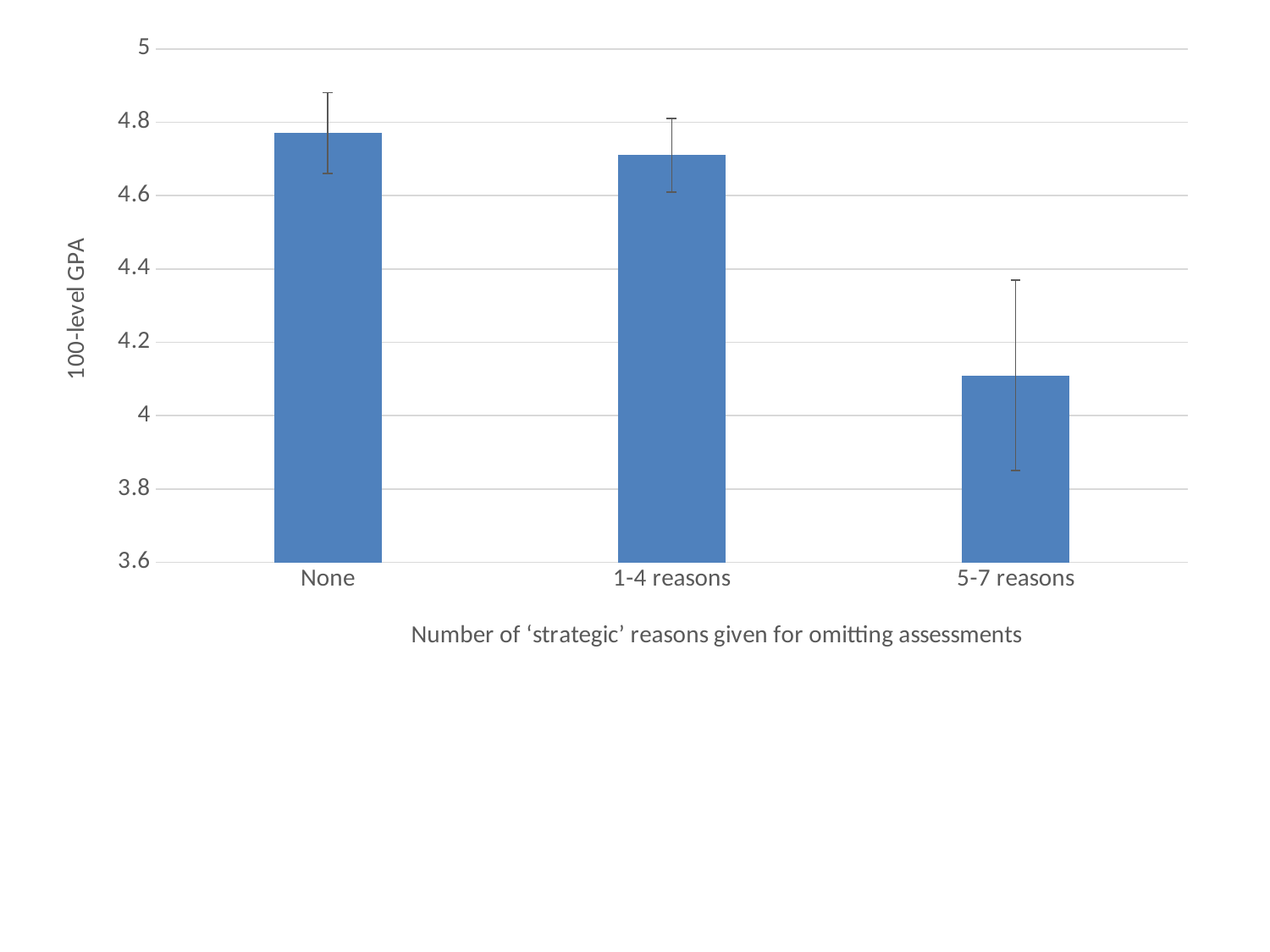
Which category has the lowest 100-level GPA? 5-7 reasons Is the value for 5-7 reasons greater or less than 4? greater Which is larger, the value for None or the value for 5-7 reasons? None Do the values rise or fall moving from left to right along the x axis? fall What is the label of the horizontal axis? Number of ‘strategic’ reasons given for omitting assessments Is the value for None greater or less than 4.6? greater What is the label of the vertical axis? 100-level GPA Is the value for 5-7 reasons greater or less than 4.2? less How many categories are shown on the x axis? 3 Which is larger, the value for 1-4 reasons or the value for 5-7 reasons? 1-4 reasons What kind of chart is shown on the slide? bar chart